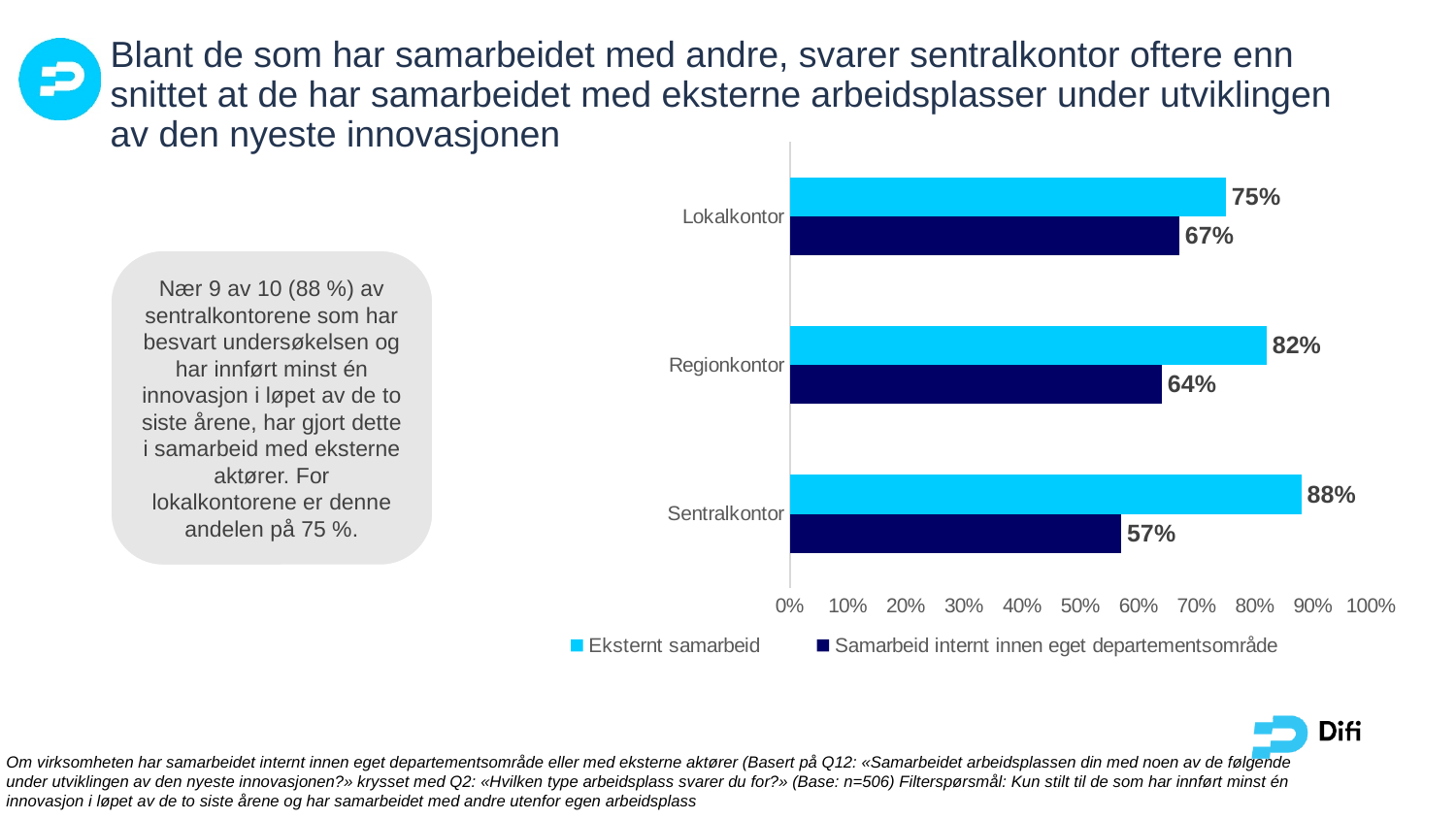
What is the difference in Eksternt samarbeid between Regionkontor and Lokalkontor? 7% Is the value for Samarbeid internt innen eget departementsområde for Lokalkontor greater or less than 60%? greater Which category has the highest value for Eksternt samarbeid? Sentralkontor Which category has the lowest value for Samarbeid internt innen eget departementsområde? Sentralkontor How many series does the legend list? 2 What is the value for Samarbeid internt innen eget departementsområde for Regionkontor? 64% What is the value for Eksternt samarbeid for Lokalkontor? 75% What kind of chart is shown on the slide? Bar chart Which is larger for Regionkontor: Eksternt samarbeid or Samarbeid internt innen eget departementsområde? Eksternt samarbeid How many categories are shown on the chart? 3 What is the difference between Eksternt samarbeid and Samarbeid internt innen eget departementsområde for Sentralkontor? 31% What is the value for Eksternt samarbeid for Sentralkontor? 88%